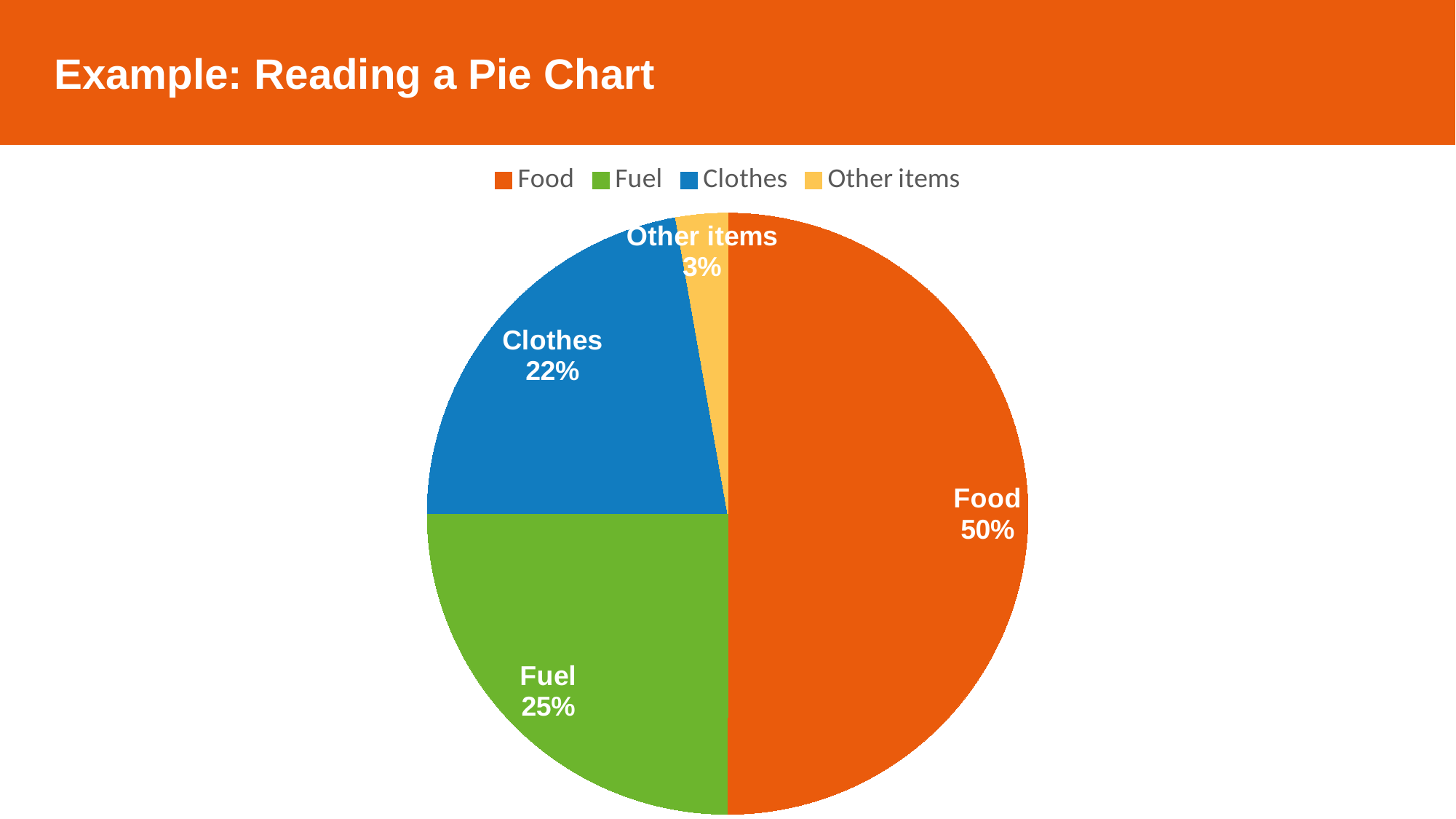
What percentage of the pie chart is Other items? 3% What percentage of the pie chart is Clothes? 22% Which is larger, the Clothes slice or the Fuel slice? Fuel What colour is the Clothes slice in the pie chart? Blue Which category has the largest slice of the pie chart? Food Which category has the smallest slice of the pie chart? Other items What percentage of the pie chart is Food? 50% What percentage of the pie chart is Fuel? 25% What is the difference in percentage points between Food and Fuel? 25 What is the difference in percentage points between Fuel and Clothes? 3 How many categories are shown in the pie chart? 4 What kind of chart is shown on the slide? Pie chart